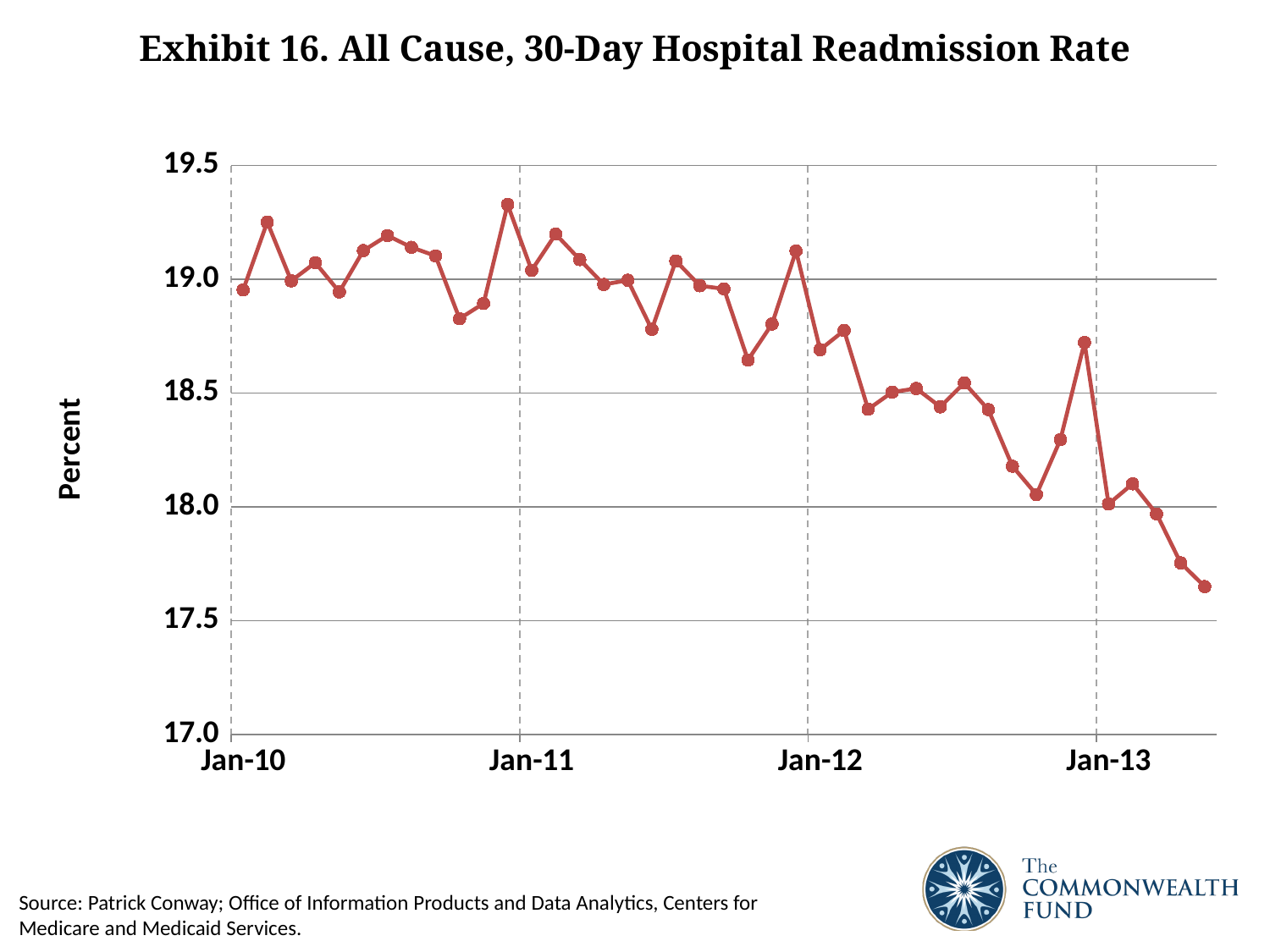
Is the value at Jan-12 greater or less than 19.0? less Overall, do the readmission rate values rise or fall from Jan-10 to the end of the series? fall Is the value at Jan-13 greater or less than 18.5? less How many year labels are shown on the horizontal axis? 4 Is the value at the last point of the series greater or less than 18.0? less What is the label on the vertical axis? Percent Which is larger, the value at Jan-12 or the value at Jan-13? Jan-12 Which is larger, the value at Jan-11 or the value at Jan-13? Jan-11 What is the title of the chart? Exhibit 16. All Cause, 30-Day Hospital Readmission Rate What kind of chart is shown on the slide? line chart